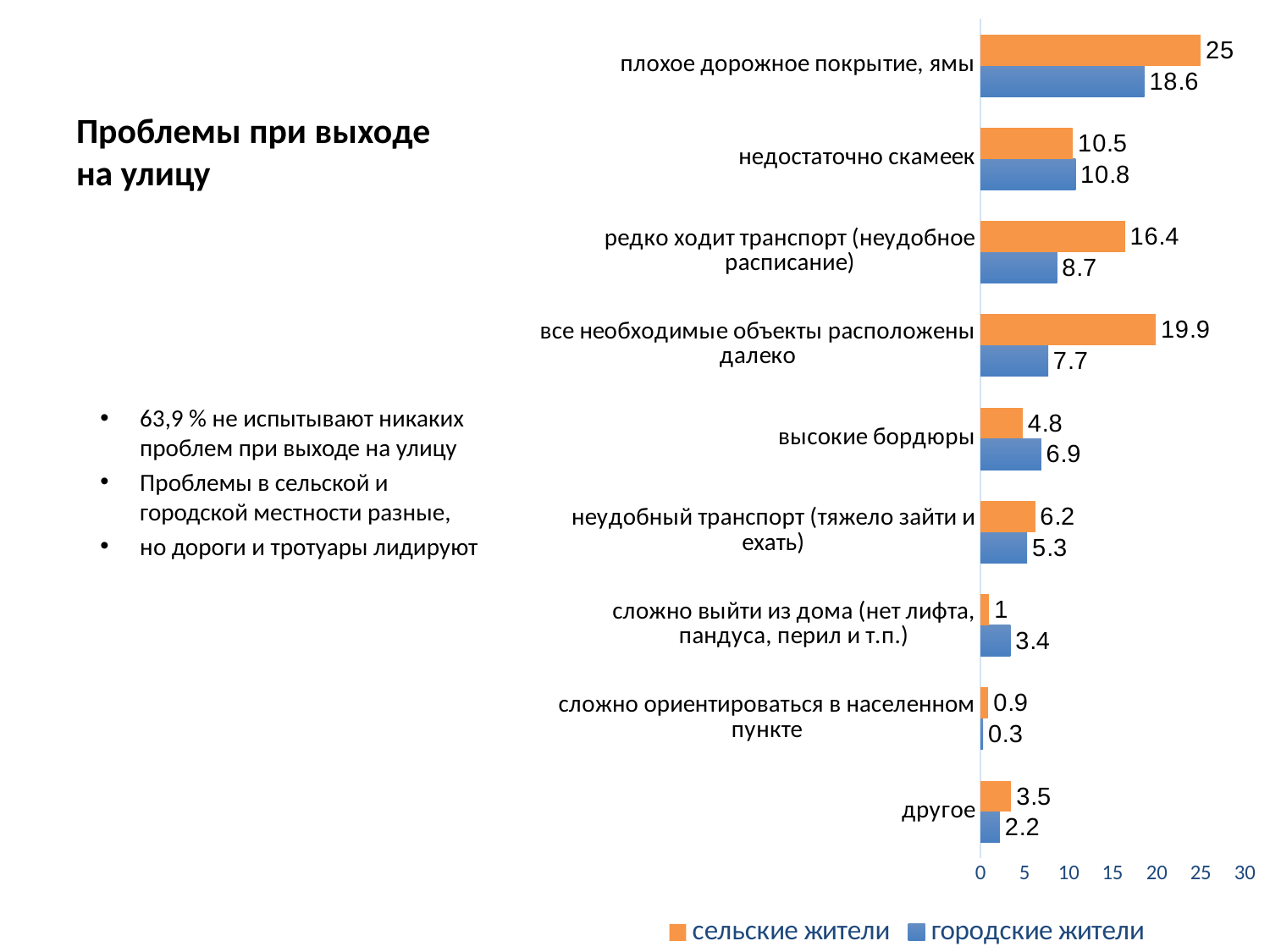
Which category has the highest value for городские жители? плохое дорожное покрытие, ямы What is the value for городские жители for 'сложно выйти из дома (нет лифта, пандуса, перил и т.п.)'? 3.4 Is the value for сельские жители for 'все необходимые объекты расположены далеко' greater or less than 15? greater Which series is shown in orange in the legend? сельские жители What type of chart is shown on the slide? bar chart Which category has the lowest value for сельские жители? сложно ориентироваться в населенном пункте What is the value for сельские жители for 'плохое дорожное покрытие, ямы'? 25 What is the difference between the сельские жители and городские жители values for 'редко ходит транспорт (неудобное расписание)'? 7.7 How many series does the legend list? 2 How many categories are shown in the chart? 9 What is the value for городские жители for 'все необходимые объекты расположены далеко'? 7.7 For 'высокие бордюры', which series has the larger value: сельские жители or городские жители? городские жители